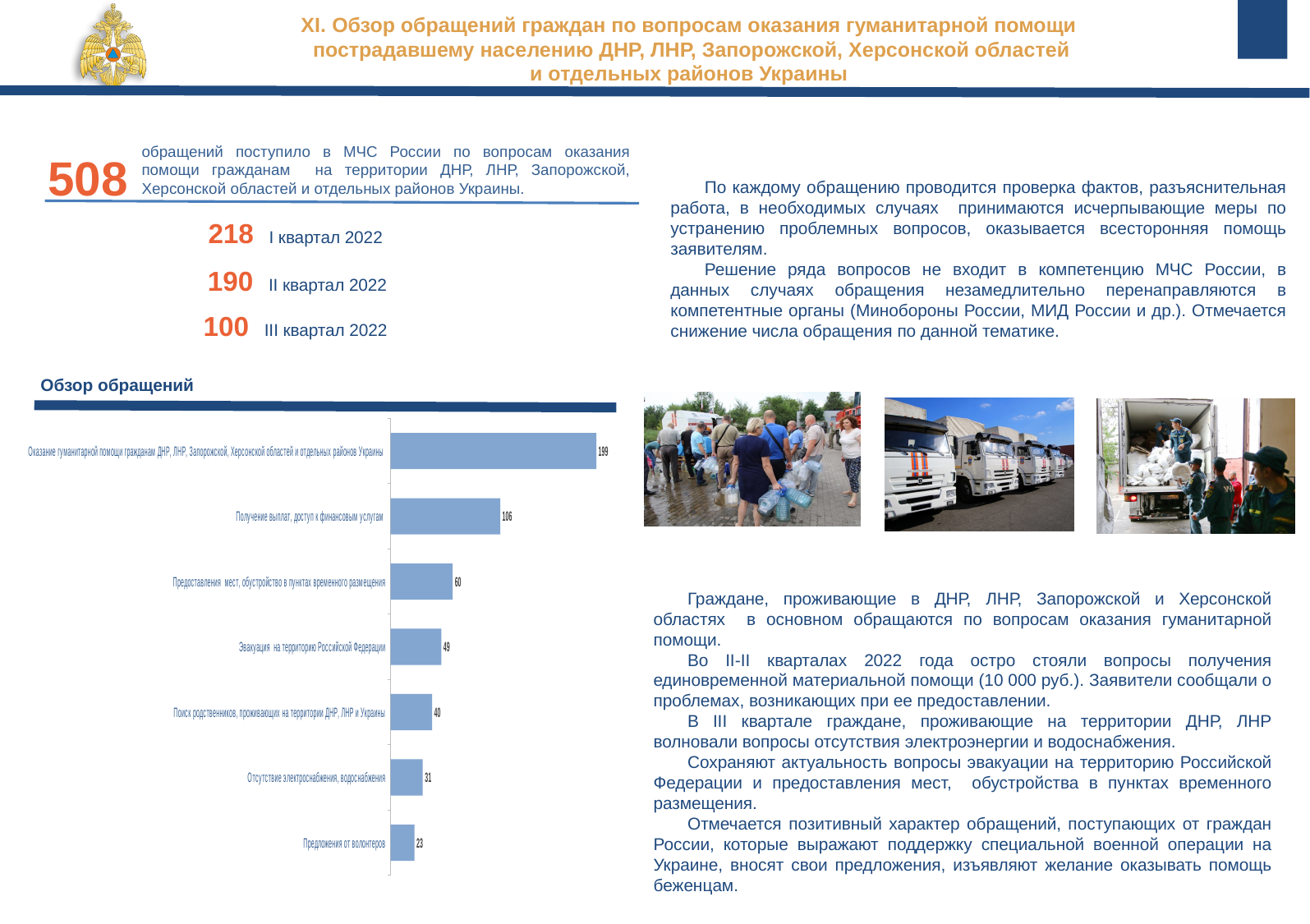
What is the value for "Предоставления мест, обустройство в пунктах временного размещения" in the "Обзор обращений" chart? 60 In the "Обзор обращений" chart, what is the difference between the values for "Оказание гуманитарной помощи..." (199) and "Получение выплат, доступ к финансовым услугам" (106)? 93 Which category has the lowest value in the "Обзор обращений" chart? Предложения от волонтеров In the "Обзор обращений" chart, which is larger: "Предоставления мест, обустройство в пунктах временного размещения" or "Поиск родственников, проживающих на территории ДНР, ЛНР и Украины"? Предоставления мест, обустройство в пунктах временного размещения Which category has the highest value in the "Обзор обращений" chart? Оказание гуманитарной помощи гражданам ДНР, ЛНР, Запорожской, Херсонской областей и отдельных районов Украины What is the value for "Эвакуация на территорию Российской Федерации" in the "Обзор обращений" chart? 49 What is the value for "Отсутствие электроснабжения, водоснабжения" in the "Обзор обращений" chart? 31 What type of chart is shown under the heading "Обзор обращений"? bar chart How many categories are plotted in the "Обзор обращений" chart? 7 What is the value for "Предложения от волонтеров" in the "Обзор обращений" chart? 23 In the "Обзор обращений" chart, what is the difference between the values for "Эвакуация на территорию Российской Федерации" and "Поиск родственников, проживающих на территории ДНР, ЛНР и Украины"? 9 What is the value for "Получение выплат, доступ к финансовым услугам" in the "Обзор обращений" chart? 106